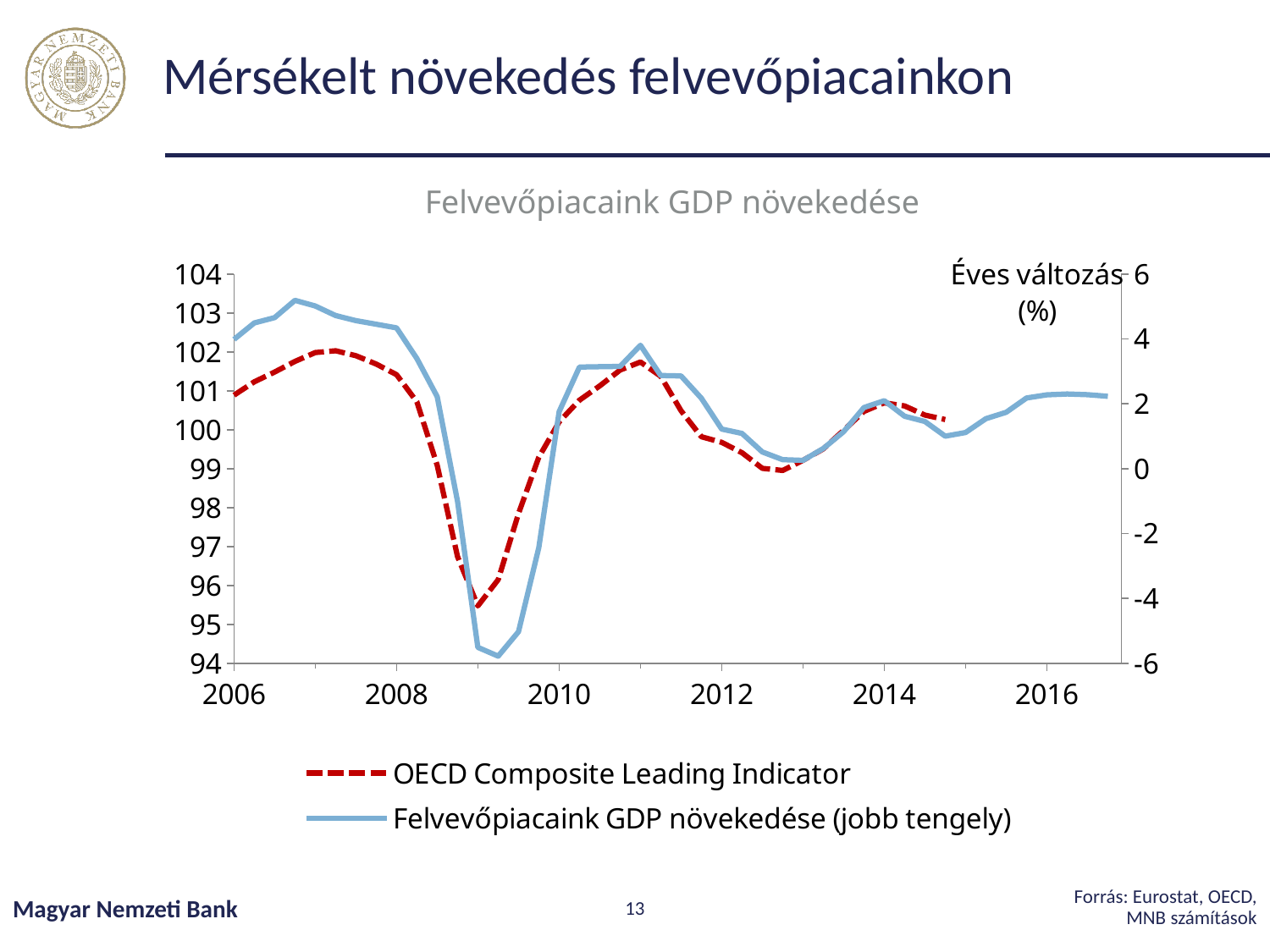
What kind of chart is shown on the slide? line chart In which year does the Felvevőpiacaink GDP növekedése line reach its lowest point? 2009 Is the value of the Felvevőpiacaink GDP növekedése line at 2007 greater or less than 4 on the right axis? greater Is the lowest value of the OECD Composite Leading Indicator line (left axis) greater or less than 97? less Which series is plotted on the right axis according to the legend? Felvevőpiacaink GDP növekedése (jobb tengely) Does the OECD Composite Leading Indicator rise or fall between 2008 and 2009? fall In which year does the OECD Composite Leading Indicator line reach its lowest point? 2009 Is the value of the OECD Composite Leading Indicator at 2008 greater or less than 100 on the left axis? greater How many series does the legend list? 2 What is the title of the chart? Felvevőpiacaink GDP növekedése Does the Felvevőpiacaink GDP növekedése line rise or fall between 2009 and 2010? rise